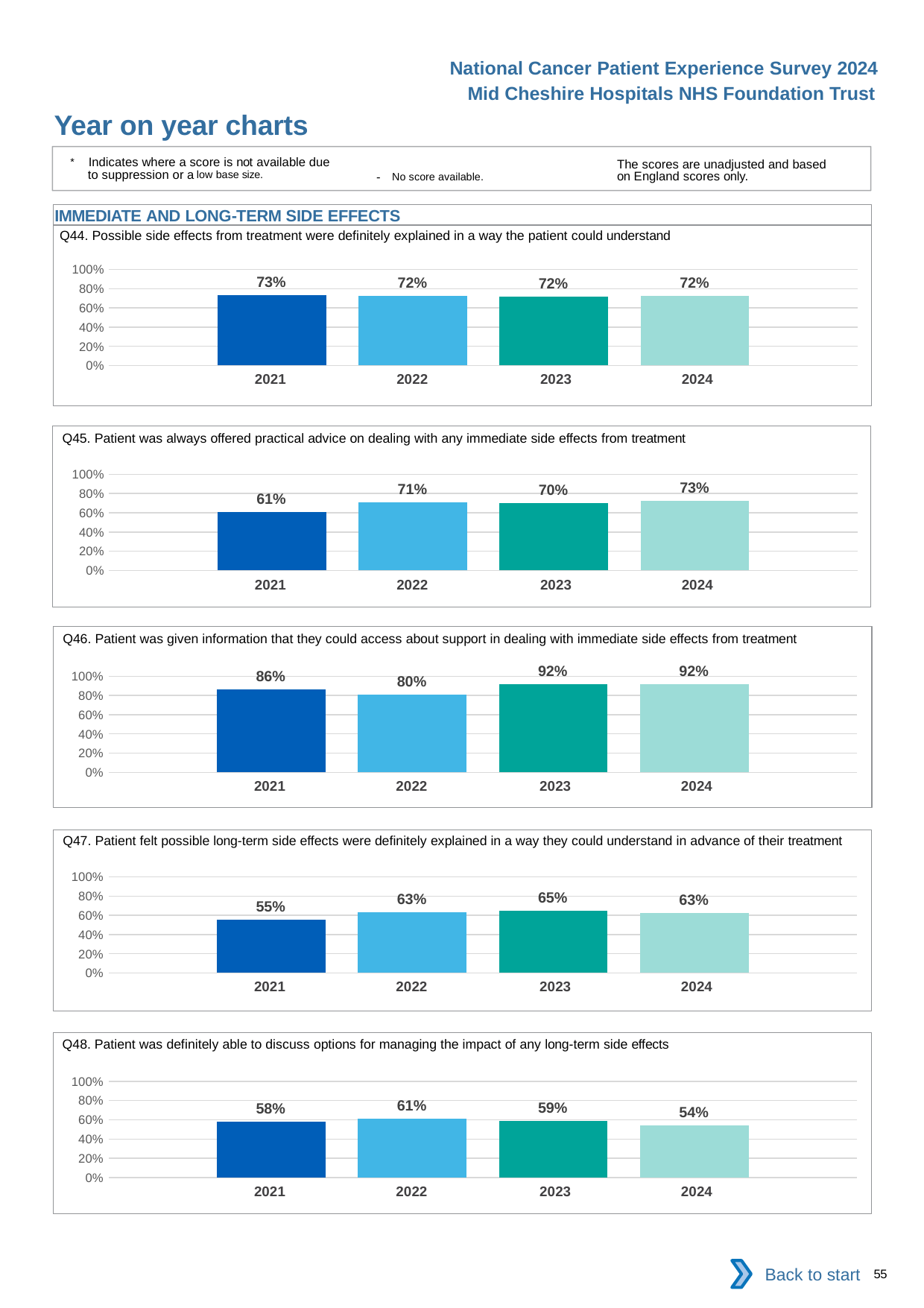
In the Q45 chart, which year has the lowest value? 2021 In the Q48 chart, what is the value for 2024? 54% In the Q45 chart, what is the difference between the 2024 value and the 2021 value? 12% In the Q48 chart, does the value rise or fall from 2023 to 2024? fall What kind of chart is the Q45 chart? bar chart In the Q46 chart, is the value for 2023 greater or less than 80%? greater In the Q46 chart, what is the value for 2022? 80% How many years are shown on the x axis of the Q44 chart? 4 In the Q44 chart, what is the value for 2021? 73% In the Q47 chart, which year has the highest value? 2023 In the Q47 chart, which is larger, the value for 2021 or the value for 2022? 2022 In the Q48 chart, what is the difference between the 2022 value and the 2024 value? 7%